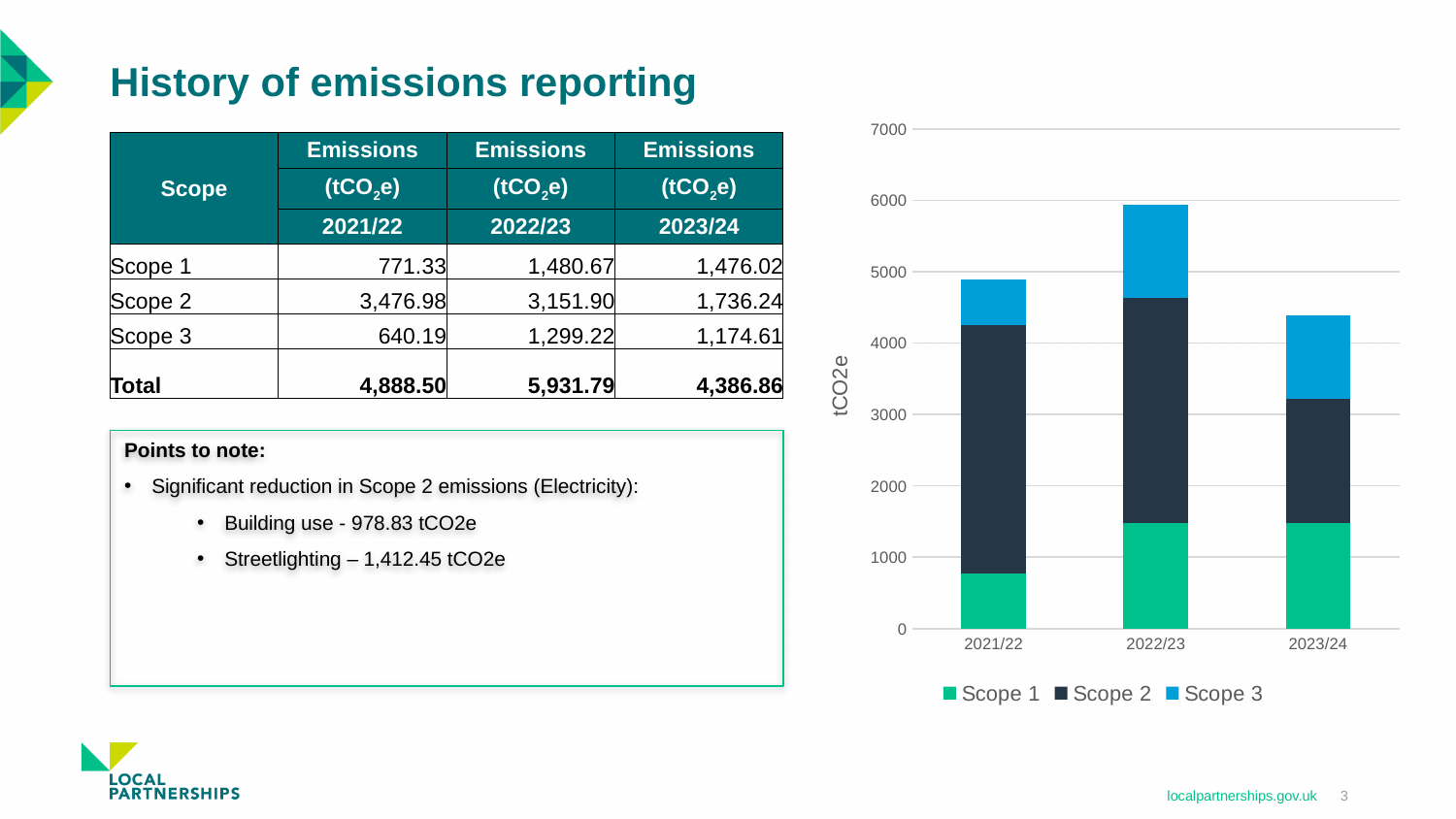
What is the Scope 2 emissions value for 2023/24, as given in the table? 1,736.24 How many years (categories) are plotted on the x axis of the chart? 3 What kind of chart is shown on the right of the slide? Stacked bar chart Which year has the tallest stacked bar in the chart? 2022/23 What is the label on the chart's vertical axis? tCO2e Is the Scope 1 segment of the 2021/22 bar greater or less than 1000? less What is the total of the stacked bar for 2022/23, as given in the table? 5,931.79 Is the total height of the 2021/22 bar greater or less than 4000? greater Do the Scope 2 segments rise or fall from 2021/22 to 2023/24? fall Is the Scope 3 segment larger in 2022/23 or in 2021/22? 2022/23 How many series does the chart's legend list? 3 Which year has the shortest stacked bar in the chart? 2023/24